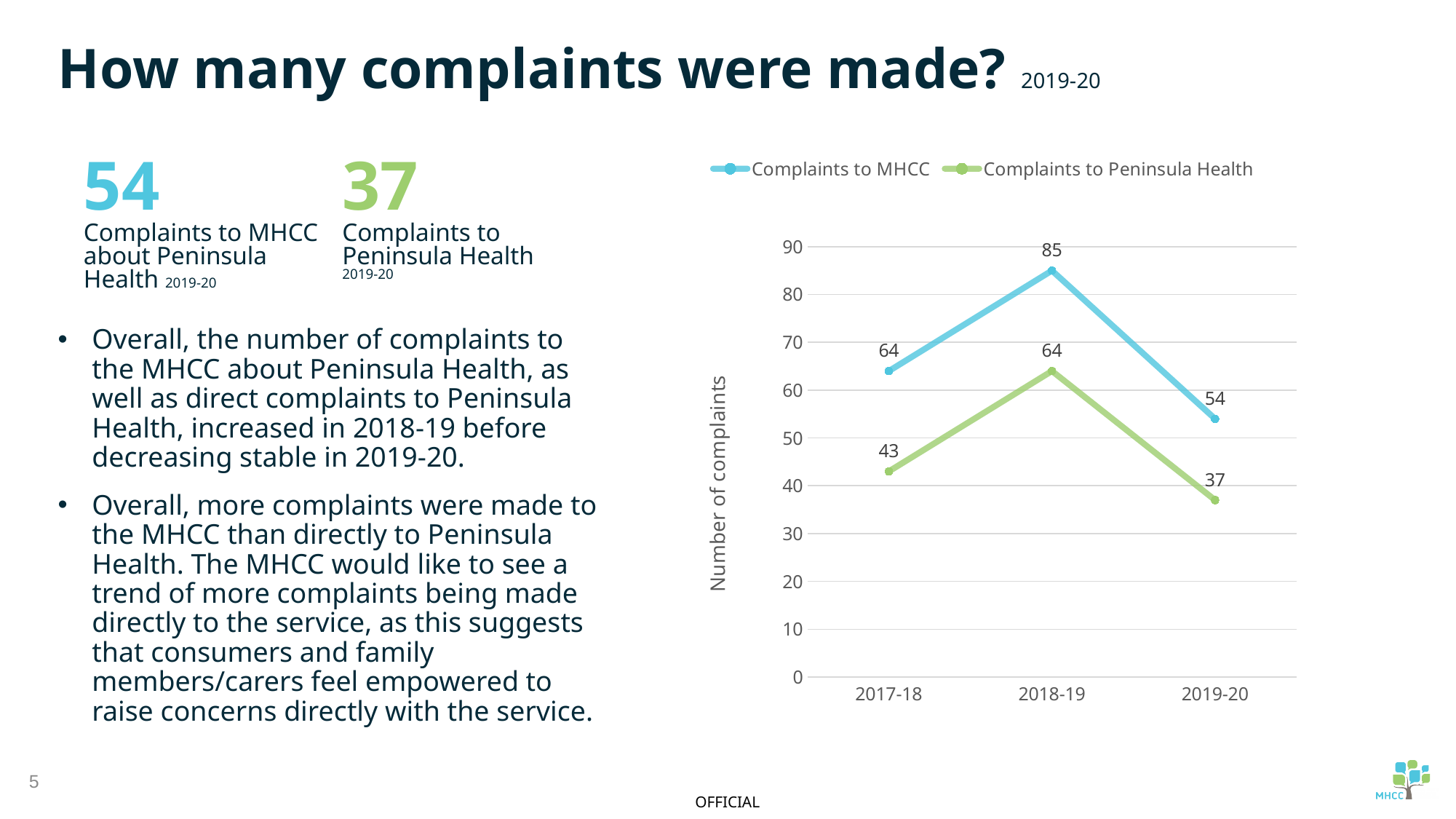
How many years are plotted on the x axis of the chart? 3 What kind of chart is shown on the slide? Line chart In which year were complaints to Peninsula Health lowest? 2019-20 Which was larger in 2017-18: complaints to MHCC or complaints to Peninsula Health? Complaints to MHCC What was the number of complaints to Peninsula Health in 2017-18? 43 What was the number of complaints to MHCC in 2018-19? 85 What is the label on the vertical axis of the chart? Number of complaints How did complaints to MHCC change from 2018-19 to 2019-20? Decreased In which year were complaints to MHCC highest? 2018-19 What is the difference between complaints to MHCC and complaints to Peninsula Health in 2018-19? 21 What was the number of complaints to Peninsula Health in 2019-20? 37 How many series does the chart legend list? 2